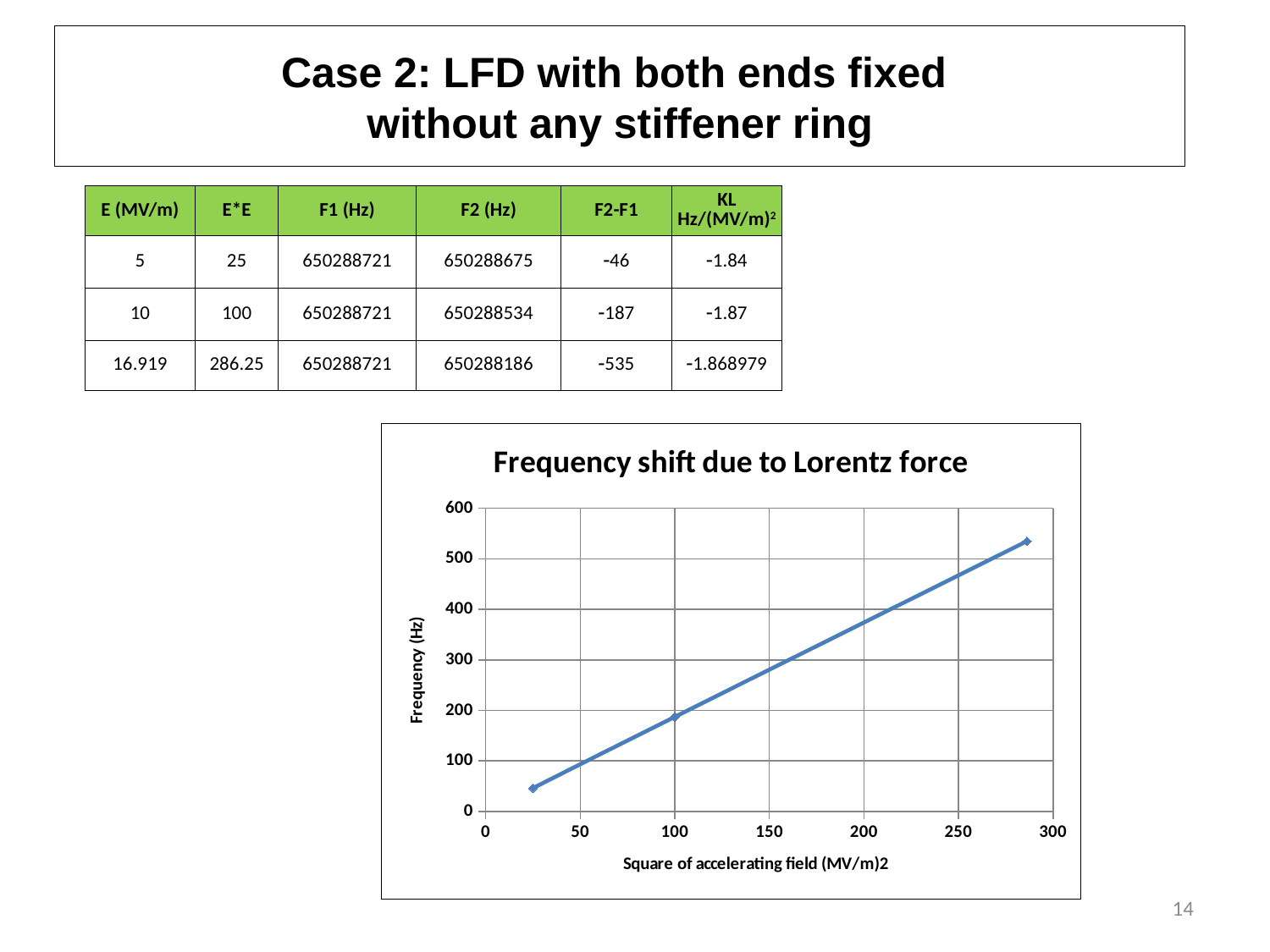
What is the label of the y axis of the chart? Frequency (Hz) How many data points are plotted on the chart? 3 What kind of chart is shown on the slide? line chart Is the frequency value at the highest x-axis point (near 286) greater or less than 500? greater Is the frequency value at x = 25 greater or less than 100? less Is the frequency value at x = 100 greater or less than 100? greater What is the title of the chart? Frequency shift due to Lorentz force What is the maximum value shown on the y axis of the chart? 600 Do the plotted values rise or fall as the square of the accelerating field increases? rise Which plotted point has the highest frequency value: the one at x = 25, x = 100, or the one near x = 286? the one near x = 286 Which plotted point has the lowest frequency value? the one at x = 25